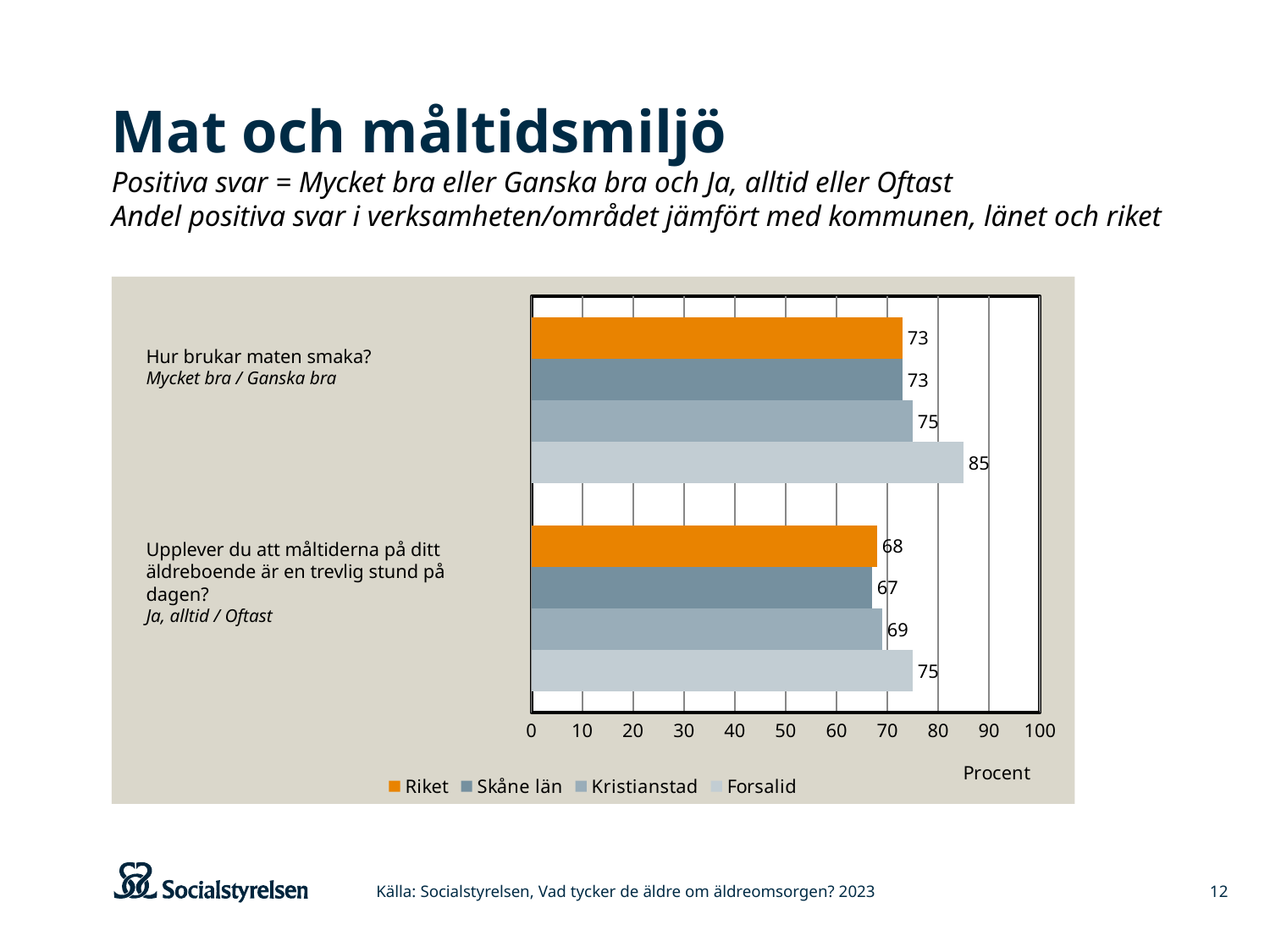
Which series has the lowest value on "Upplever du att måltiderna på ditt äldreboende är en trevlig stund på dagen?"? Skåne län What is the difference between Forsalid and Riket on "Hur brukar maten smaka?"? 12 What is the value for Forsalid on "Hur brukar maten smaka?"? 85 How many series does the legend list? 4 What kind of chart is shown on the slide? Bar chart What is the value for Skåne län on "Upplever du att måltiderna på ditt äldreboende är en trevlig stund på dagen?"? 67 What is the value for Kristianstad on "Hur brukar maten smaka?"? 75 What unit label is shown under the x axis? Procent Which series has the highest value on "Hur brukar maten smaka?"? Forsalid Which is larger for Forsalid: the value on "Hur brukar maten smaka?" or on "Upplever du att måltiderna på ditt äldreboende är en trevlig stund på dagen?"? Hur brukar maten smaka? What is the value for Riket on "Upplever du att måltiderna på ditt äldreboende är en trevlig stund på dagen?"? 68 What is the difference between Forsalid and Kristianstad on "Upplever du att måltiderna på ditt äldreboende är en trevlig stund på dagen?"? 6